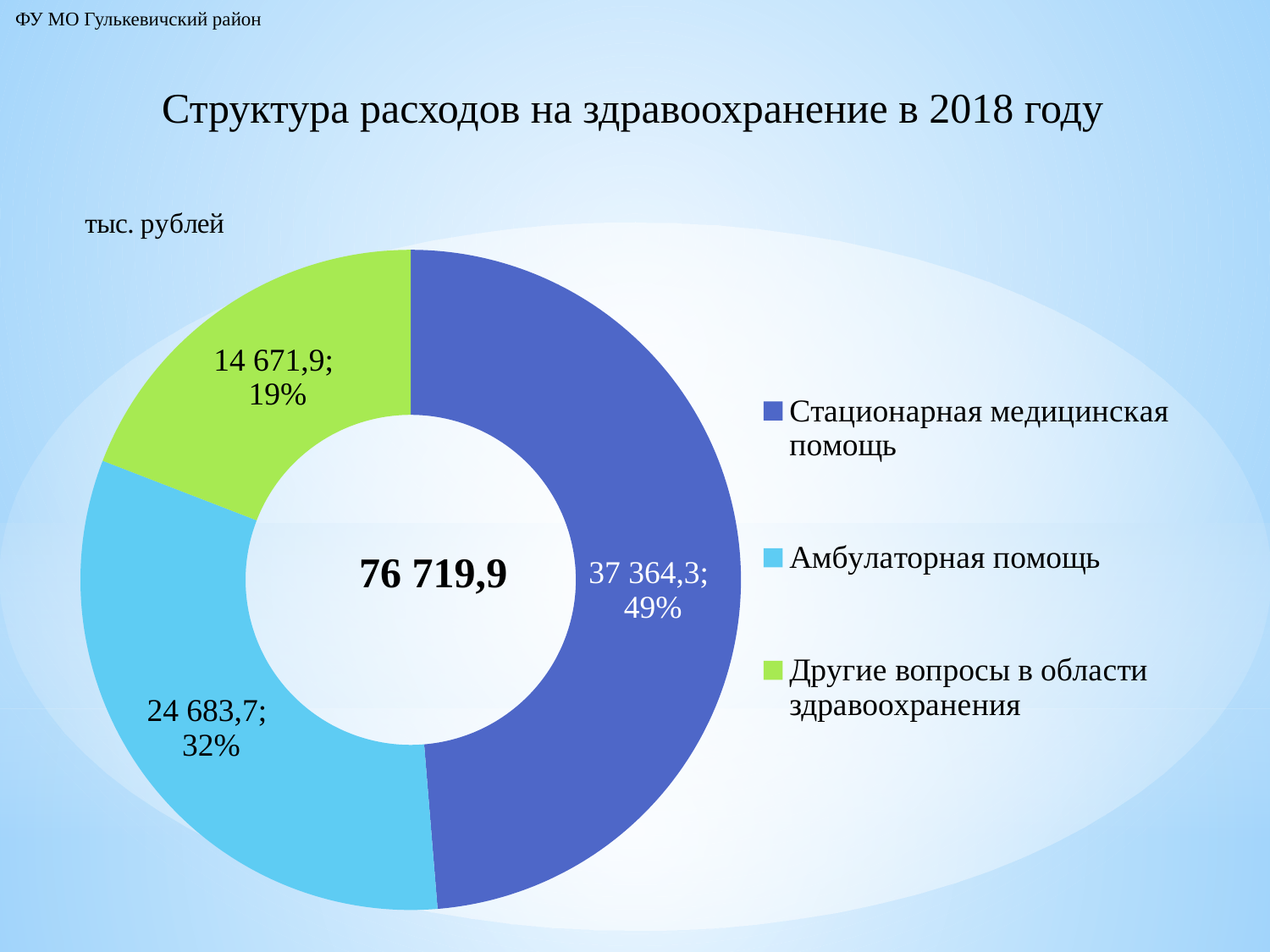
What share of the chart does Другие вопросы в области здравоохранения represent? 19% Which category has the smallest value? Другие вопросы в области здравоохранения What is the difference between the values for Стационарная медицинская помощь and Амбулаторная помощь? 12 680,6 What kind of chart is shown on the slide? doughnut chart What is the value for Другие вопросы в области здравоохранения? 14 671,9 Which category has the largest value? Стационарная медицинская помощь What share of the chart does Амбулаторная помощь represent? 32% Which is larger: Амбулаторная помощь or Другие вопросы в области здравоохранения? Амбулаторная помощь What is the value for Стационарная медицинская помощь? 37 364,3 What total value is shown in the centre of the chart? 76 719,9 What is the value for Амбулаторная помощь? 24 683,7 How many categories does the chart show? 3